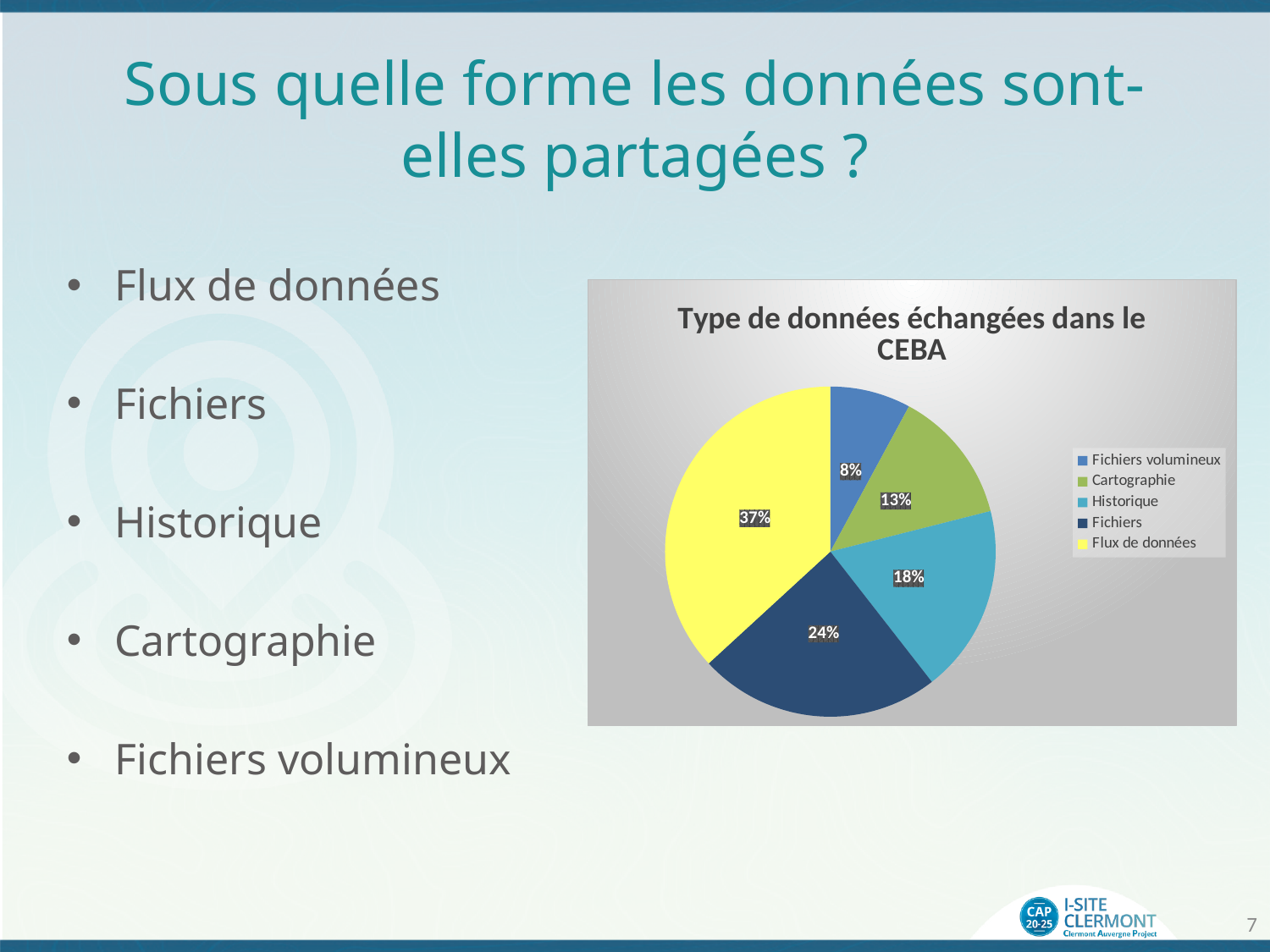
What share of the pie does Fichiers volumineux represent? 8% How many categories does the legend list? 5 What is the title of the chart? Type de données échangées dans le CEBA What type of chart is shown on the slide? pie chart What share of the pie does Flux de données represent? 37% Which category has the smallest slice of the pie? Fichiers volumineux Which is larger, the share for Historique or the share for Cartographie? Historique What share of the pie does Fichiers represent? 24% Which category has the largest slice of the pie? Flux de données What is the difference in percentage points between Flux de données and Fichiers? 13